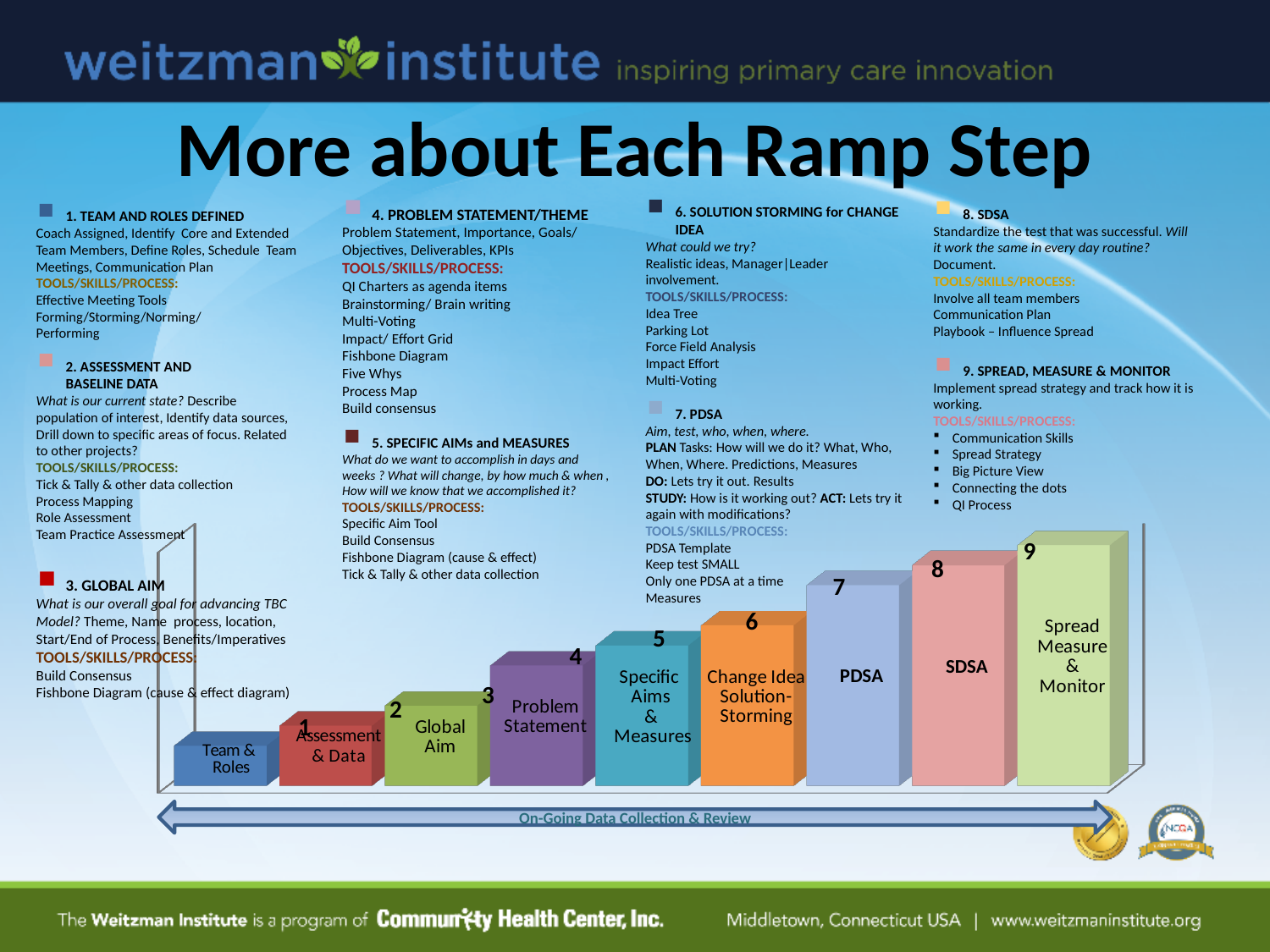
What number is labelled on the Global Aim bar? 3 How many bars (ramp steps) does the chart show? 9 What kind of chart is shown at the bottom of the slide? bar chart What text appears on the arrow beneath the bars? On-Going Data Collection & Review What label is on the bar numbered 5? Specific Aims & Measures Which bar in the chart is the tallest? Spread Measure & Monitor What number is labelled on the Change Idea Solution-Storming bar? 6 Do the bar heights rise or fall from left to right across the chart? rise Which bar is taller, SDSA or Problem Statement? SDSA What is the difference between the numbers labelled on the Spread Measure & Monitor bar and the Team & Roles bar? 8 Which bar in the chart is the shortest? Team & Roles What number is labelled on the PDSA bar? 7